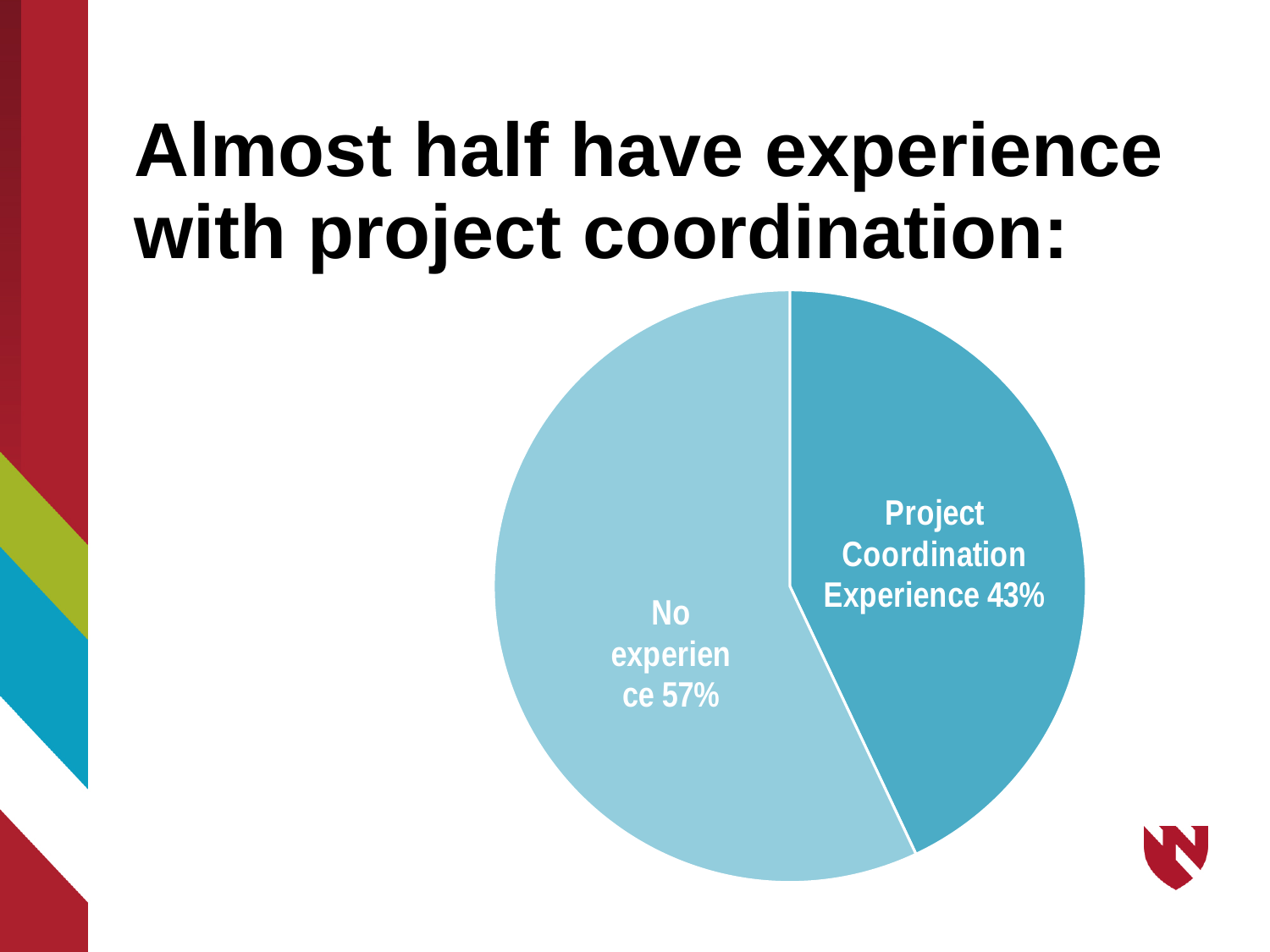
Which slice of the pie is drawn in the darker blue colour? Project Coordination Experience What is the difference in percentage points between the "No experience" slice and the "Project Coordination Experience" slice? 14 What share of the pie is labelled "Project Coordination Experience"? 43% What kind of chart is shown on the slide? pie chart Which slice of the pie is the smallest? Project Coordination Experience How many slices does the pie chart have? 2 Which is larger: the "No experience" slice or the "Project Coordination Experience" slice? No experience What is the title text on the slide above the pie chart? Almost half have experience with project coordination: What share of the pie is labelled "No experience"? 57% Is the share for "Project Coordination Experience" greater or less than 50%? less Which slice of the pie is the largest? No experience